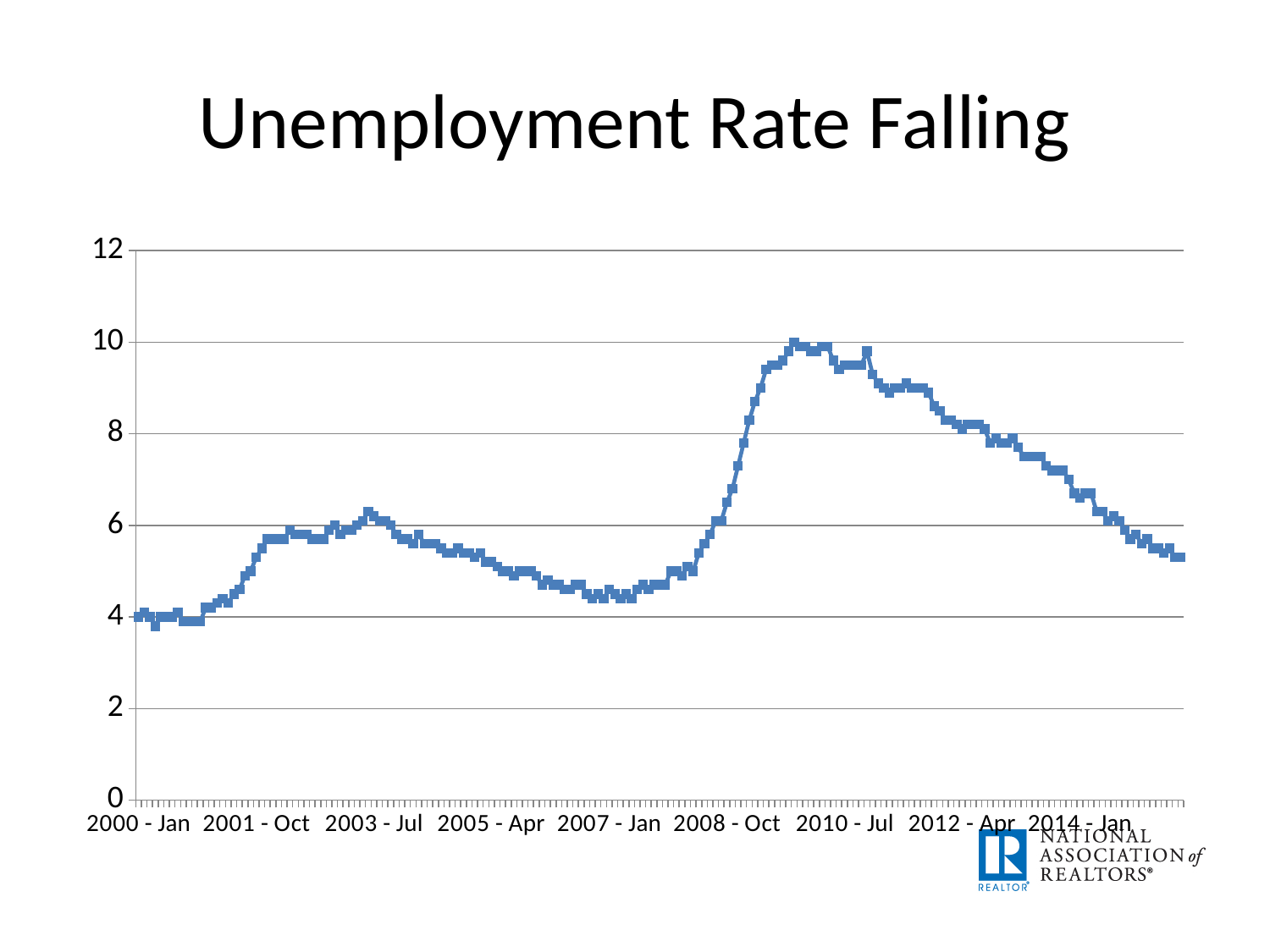
How many lines are plotted on the chart? 1 Is the value at 2014 - Jan greater or less than 8? less What is the title of the chart? Unemployment Rate Falling Is the highest point on the line greater or less than 8? greater Is the value at 2000 - Jan greater or less than 6? less How many labels are shown on the x axis? 9 Does the line rise or fall between 2007 - Jan and 2008 - Oct? rise Which is larger, the value at 2010 - Jul or the value at 2000 - Jan? 2010 - Jul Does the line rise or fall between 2010 - Jul and 2014 - Jan? fall What kind of chart is shown on the slide? line chart